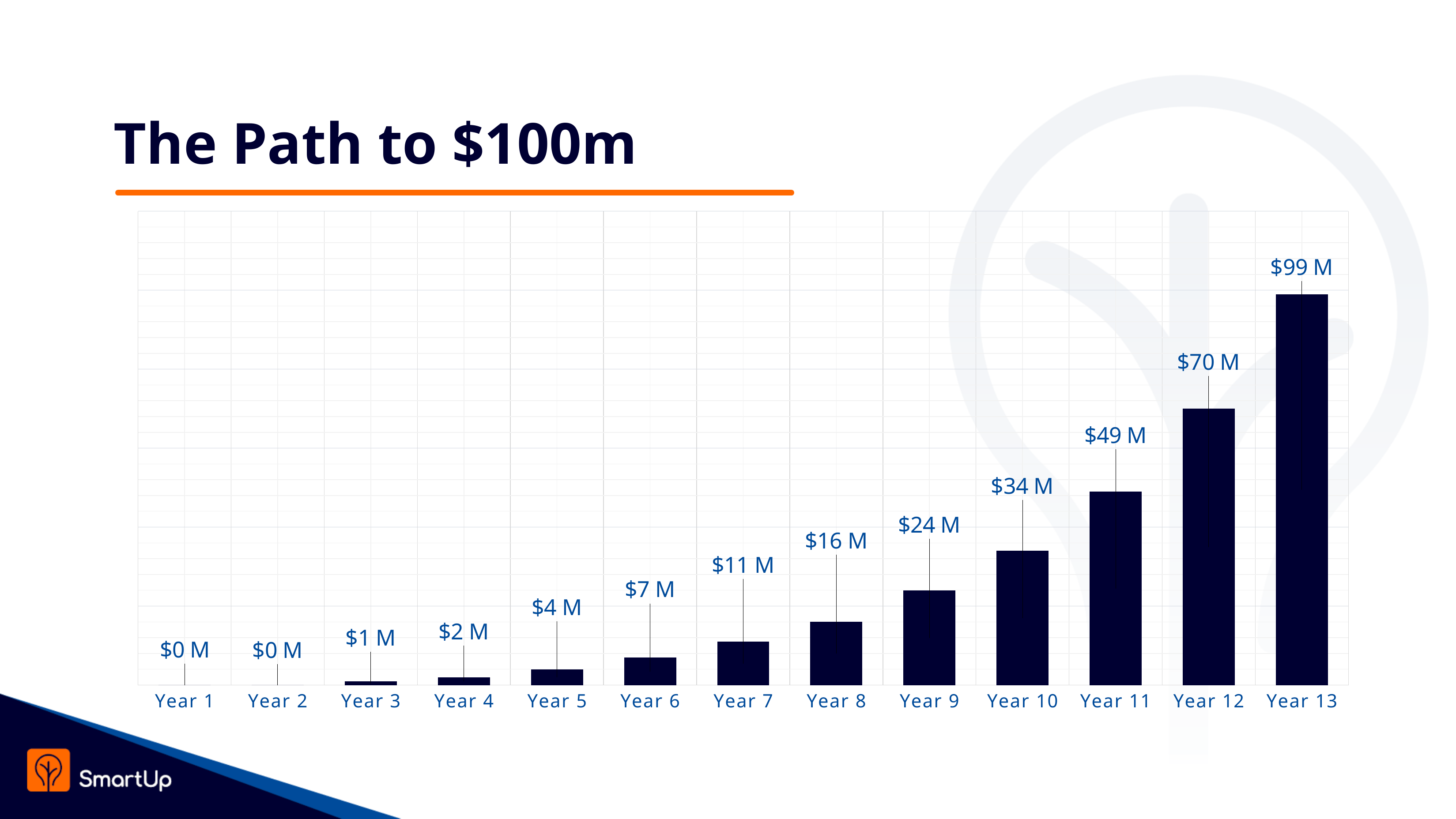
Which year has the highest value? Year 13 Do the values rise or fall from Year 1 to Year 13? Rise What is the difference between the values for Year 10 and Year 8? $18 M What is the value for Year 6? $7 M What is the value for Year 9? $24 M What is the title of the slide? The Path to $100m Which is larger, the value for Year 7 or the value for Year 5? Year 7 What is the value for Year 13? $99 M How many years are shown on the x axis? 13 What kind of chart is shown on the slide? Bar chart What is the difference between the values for Year 12 and Year 11? $21 M What is the value for Year 3? $1 M